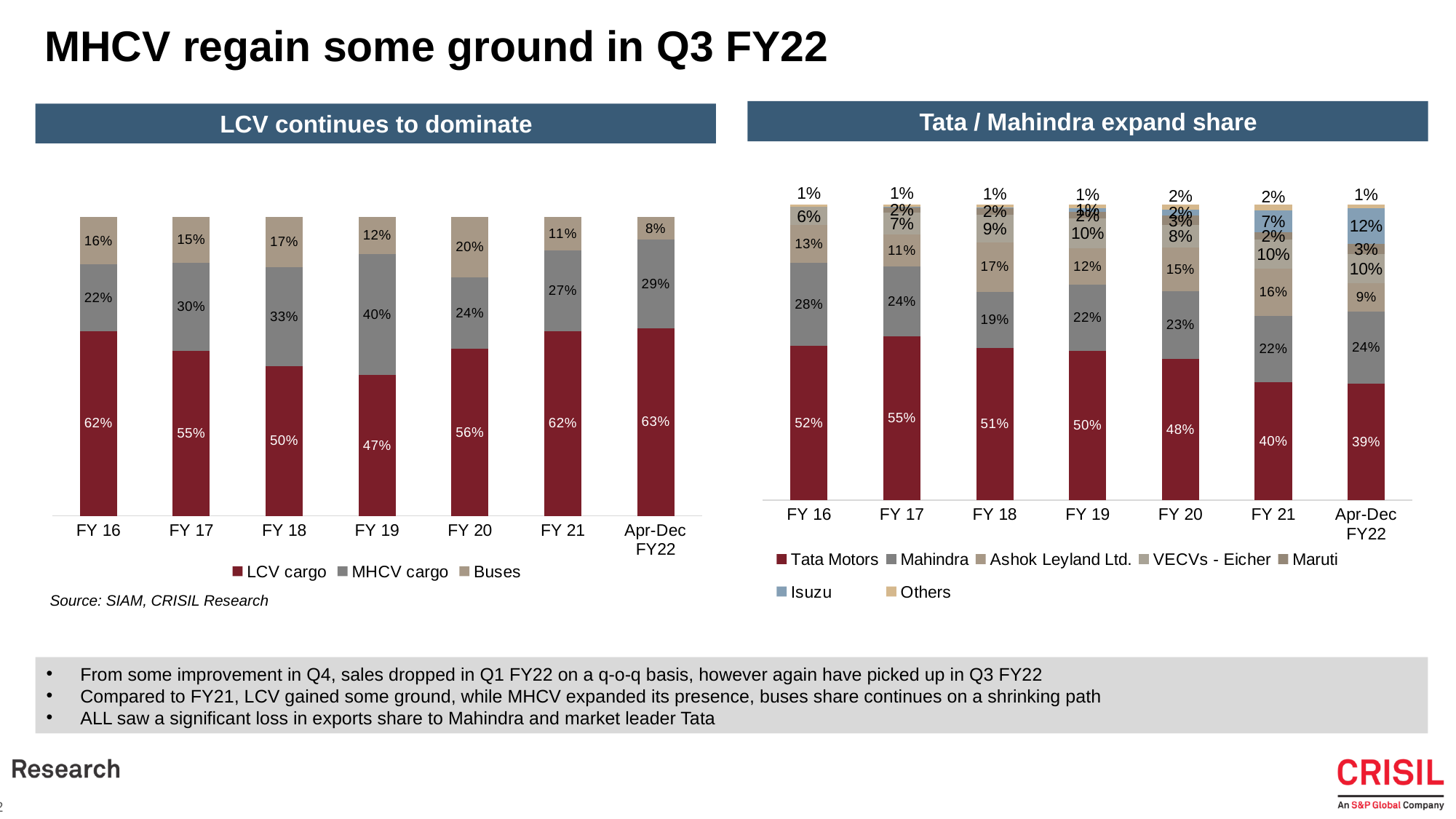
In the 'Tata / Mahindra expand share' chart, what is Isuzu's share in Apr-Dec FY22? 12% In the 'LCV continues to dominate' chart, how many periods are shown on the x axis? 7 In the 'Tata / Mahindra expand share' chart, what is Tata Motors' share in FY 20? 48% In the 'Tata / Mahindra expand share' chart, what is Ashok Leyland Ltd.'s share in FY 18? 17% In the 'Tata / Mahindra expand share' chart, is Mahindra's share larger in FY 16 or FY 18? FY 16 In the 'LCV continues to dominate' chart, how many series does the legend list? 3 In the 'LCV continues to dominate' chart, what is the LCV cargo share in FY 19? 47% In the 'LCV continues to dominate' chart, what is the difference between the LCV cargo share in FY 16 and FY 19? 15% What type of chart is the 'Tata / Mahindra expand share' chart? Stacked bar chart In the 'Tata / Mahindra expand share' chart, which period has the lowest Tata Motors share? Apr-Dec FY22 In the 'LCV continues to dominate' chart, what is the Buses share in Apr-Dec FY22? 8% In the 'LCV continues to dominate' chart, which year has the highest MHCV cargo share? FY 19